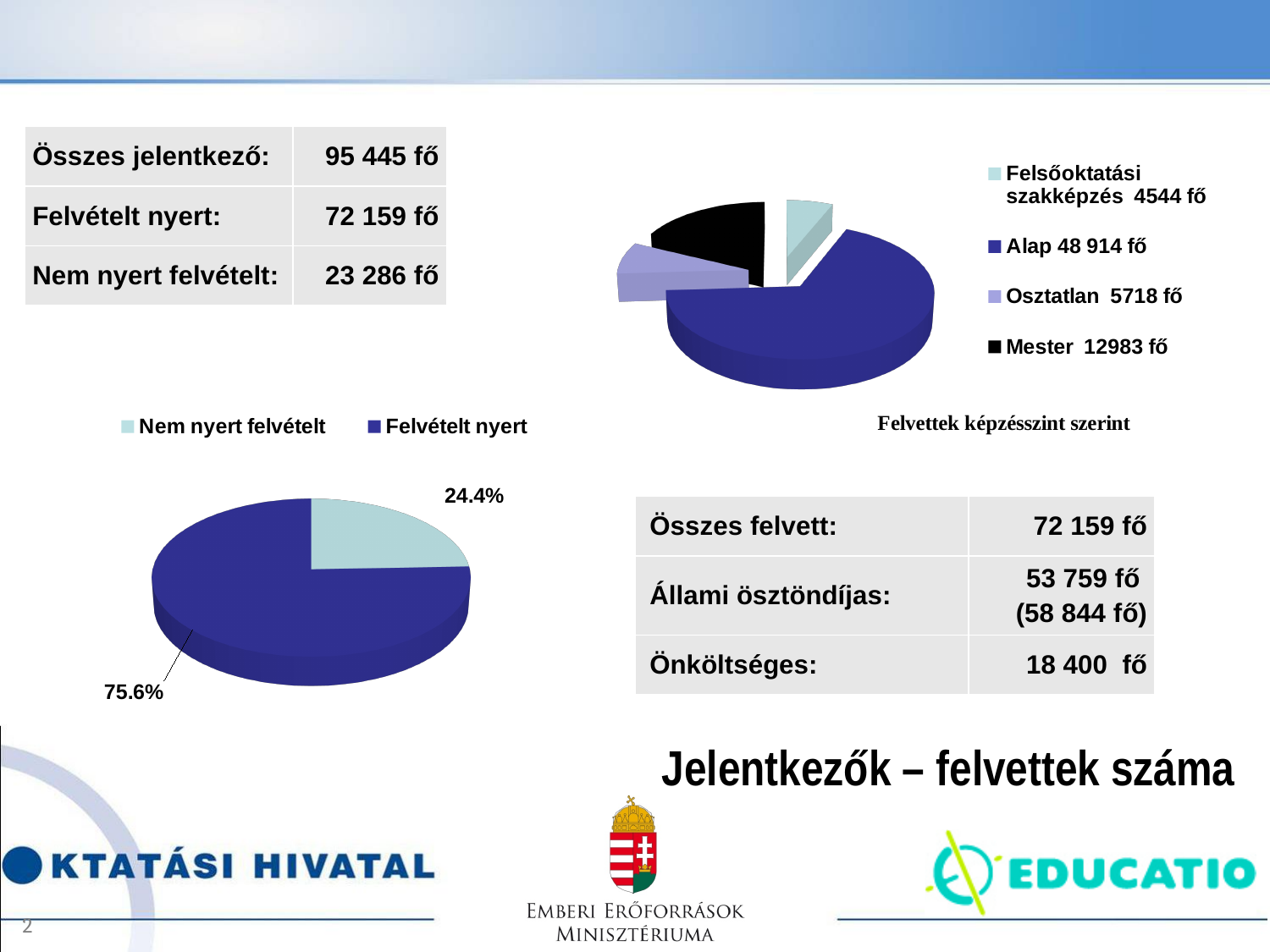
In the pie chart titled 'Felvettek képzésszint szerint', what is the value for Alap? 48 914 fő What kind of chart is shown at the bottom left of the slide? Pie chart In the pie chart titled 'Felvettek képzésszint szerint', what is the value for Felsőoktatási szakképzés? 4544 fő In the pie chart titled 'Felvettek képzésszint szerint', what is the value for Mester? 12983 fő In the pie chart titled 'Felvettek képzésszint szerint', how many categories does the legend list? 4 In the pie chart titled 'Felvettek képzésszint szerint', which category has the largest value? Alap In the pie chart at the bottom left of the slide, what share is labelled for 'Felvételt nyert'? 75.6% In the pie chart titled 'Felvettek képzésszint szerint', which category has the smallest value? Felsőoktatási szakképzés In the pie chart at the bottom left of the slide, how many entries does the legend list? 2 In the pie chart titled 'Felvettek képzésszint szerint', which is larger: Osztatlan or Mester? Mester In the pie chart at the bottom left of the slide, what share is labelled for 'Nem nyert felvételt'? 24.4% In the pie chart at the bottom left of the slide, which slice is larger: 'Nem nyert felvételt' or 'Felvételt nyert'? Felvételt nyert